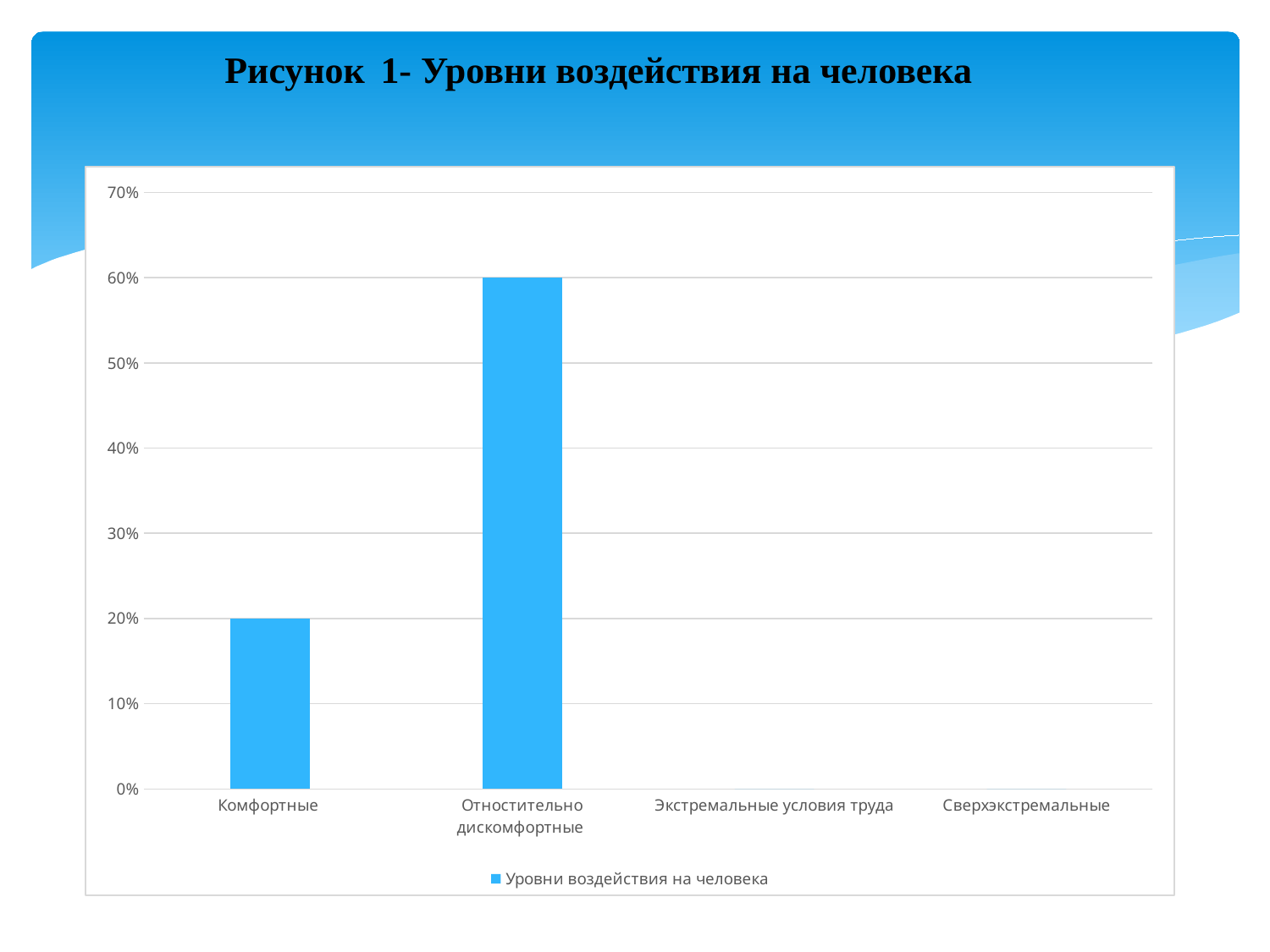
What is the value for Комфортные? 20% What is the difference between the values for Относительно дискомфортные and Комфортные? 40% What type of chart is shown on the slide? bar chart Which is larger, the value for Комфортные or the value for Относительно дискомфортные? Отностительно дискомфортные Is the value for Комфортные greater or less than 30%? less What is the name of the series in the legend? Уровни воздействия на человека Which category has the highest value? Отностительно дискомфортные How many categories are shown on the x axis? 4 Is the value for Относительно дискомфортные greater or less than 50%? greater How many series does the legend list? 1 What is the title of the chart on the slide? Рисунок 1- Уровни воздействия на человека What is the value for Относительно дискомфортные? 60%